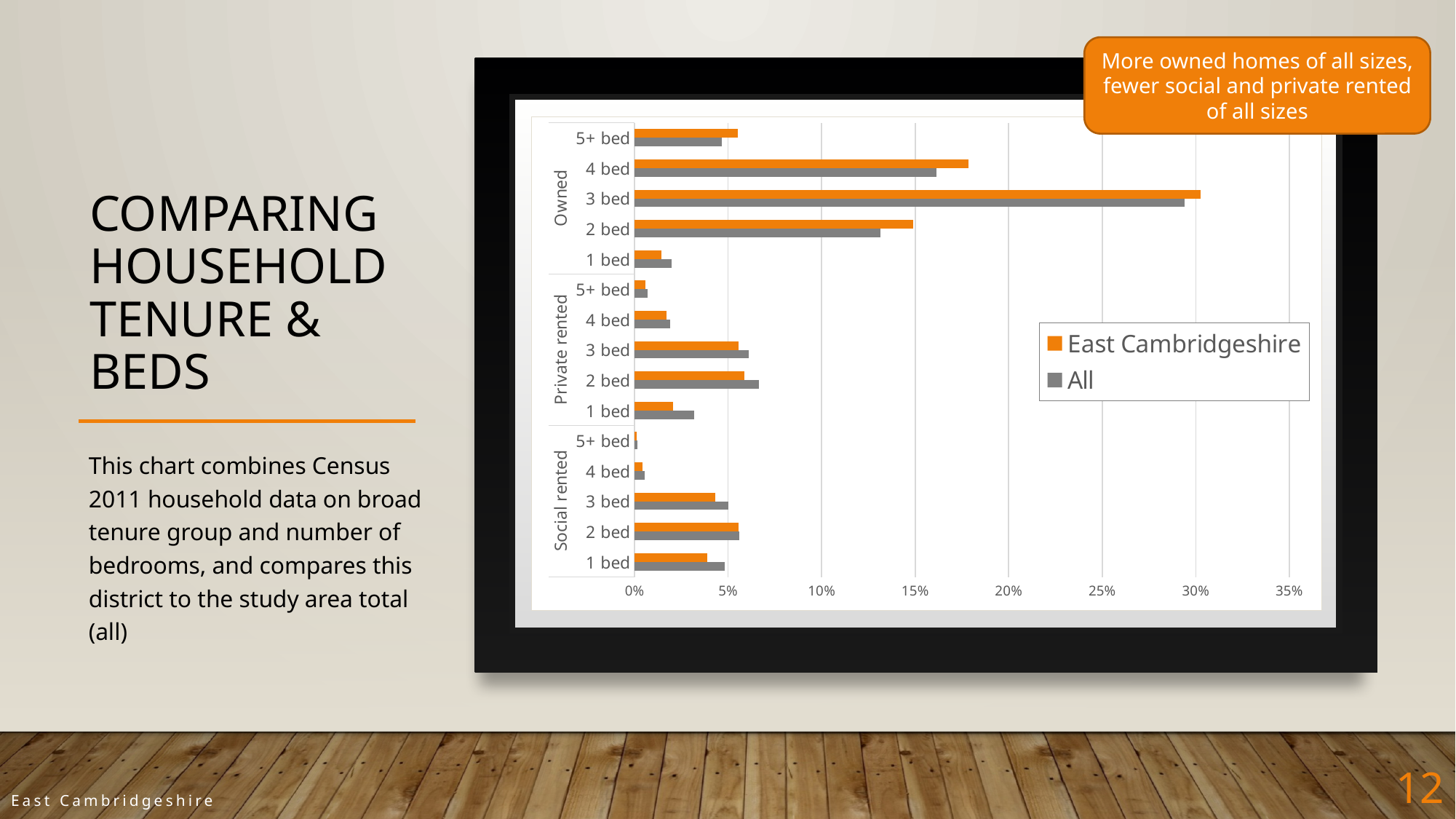
For Owned 4 bed, which series has the larger value, East Cambridgeshire or All? East Cambridgeshire What colour represents the East Cambridgeshire series in the chart? orange Is the East Cambridgeshire value for Owned 3 bed greater or less than 25%? greater How many bedroom categories are plotted in total across the three tenure groups? 15 Is the East Cambridgeshire value for Owned 4 bed greater or less than 15%? greater How many series does the chart legend list? 2 Is the All value for Owned 2 bed greater or less than 15%? less Which tenure and bedroom category has the highest value for East Cambridgeshire? Owned 3 bed For Private rented 1 bed, which series has the larger value, East Cambridgeshire or All? All Which tenure and bedroom category has the lowest value for East Cambridgeshire? Social rented 5+ bed What kind of chart is shown on the slide? bar chart